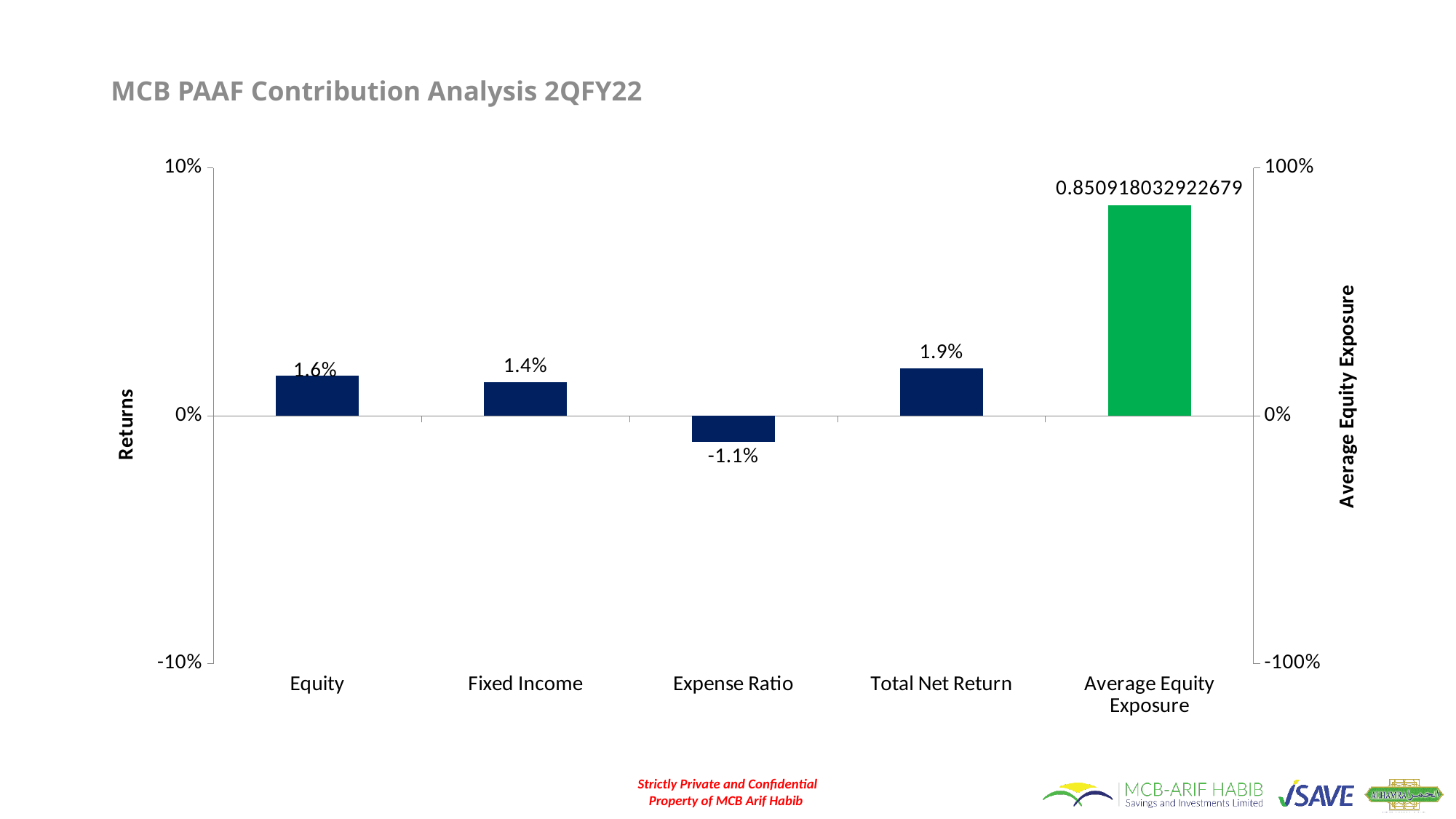
What data label is printed above the Average Equity Exposure bar? 0.850918032922679 How many categories are shown on the x axis? 5 Which is larger, the value for Equity or the value for Fixed Income? Equity What type of chart is shown on the slide? Bar chart Among Equity, Fixed Income and Total Net Return, which has the highest return? Total Net Return What is the title of the chart? MCB PAAF Contribution Analysis 2QFY22 What is the value shown for Equity? 1.6% Which category has the lowest value on the chart? Expense Ratio What is the difference between the Equity value and the Fixed Income value? 0.2% What is the value shown for Total Net Return? 1.9% What is the value shown for Expense Ratio? -1.1% What is the value shown for Fixed Income? 1.4%